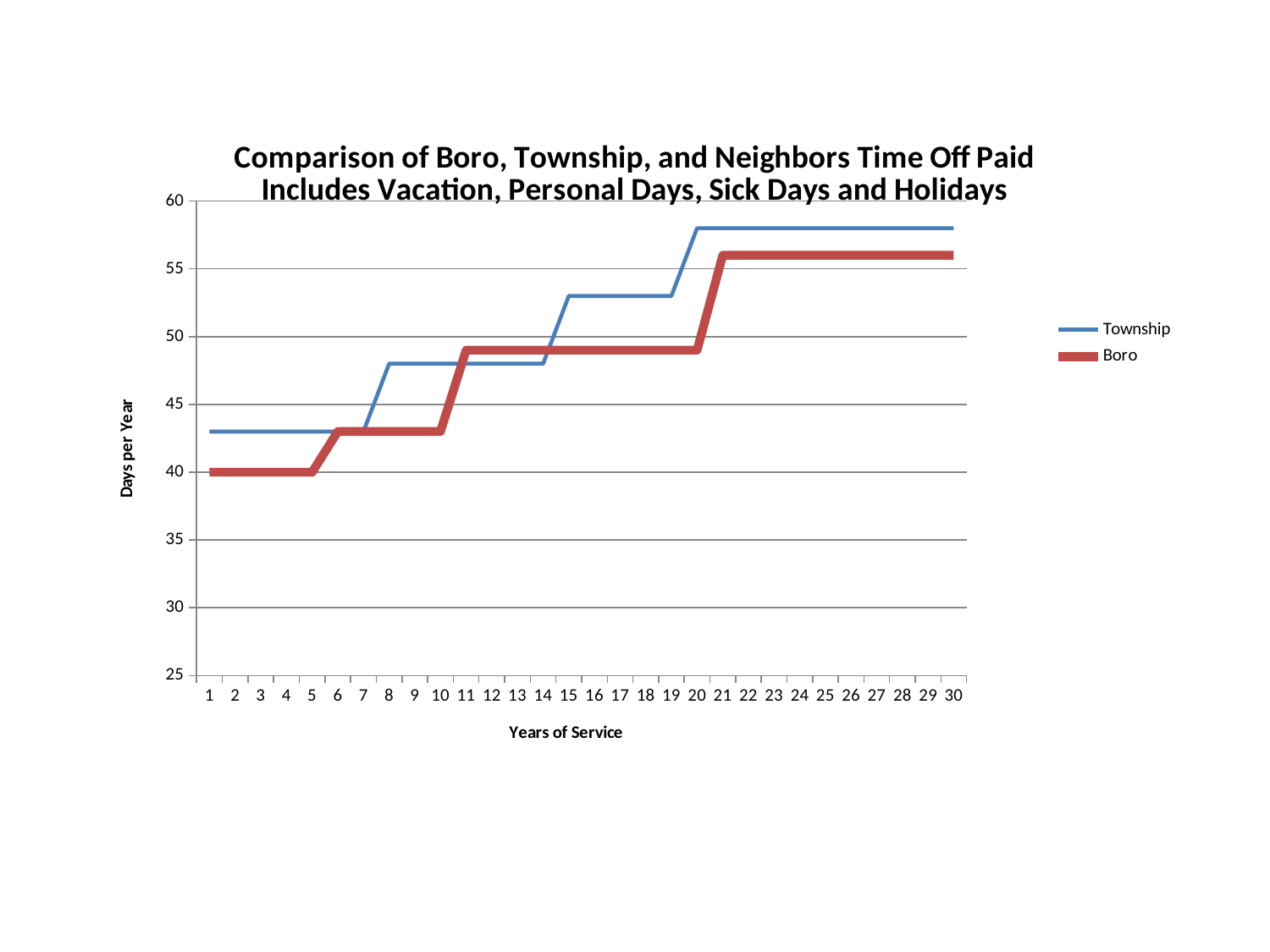
Is the value for Township at year 30 greater or less than 55? greater Do the values for Township rise or fall as years of service increase? rise Which series has the higher value at year 25 of service, Township or Boro? Township What is the value for Boro at year 5 of service? 40 What is the value for Boro at year 1 of service? 40 Which series has the higher value at year 12 of service, Township or Boro? Boro How many years of service are shown along the x axis? 30 How many series does the legend list? 2 What kind of chart is shown on the slide? line chart What are the two series named in the legend? Township and Boro Is the value for Township at year 10 greater or less than 45? greater